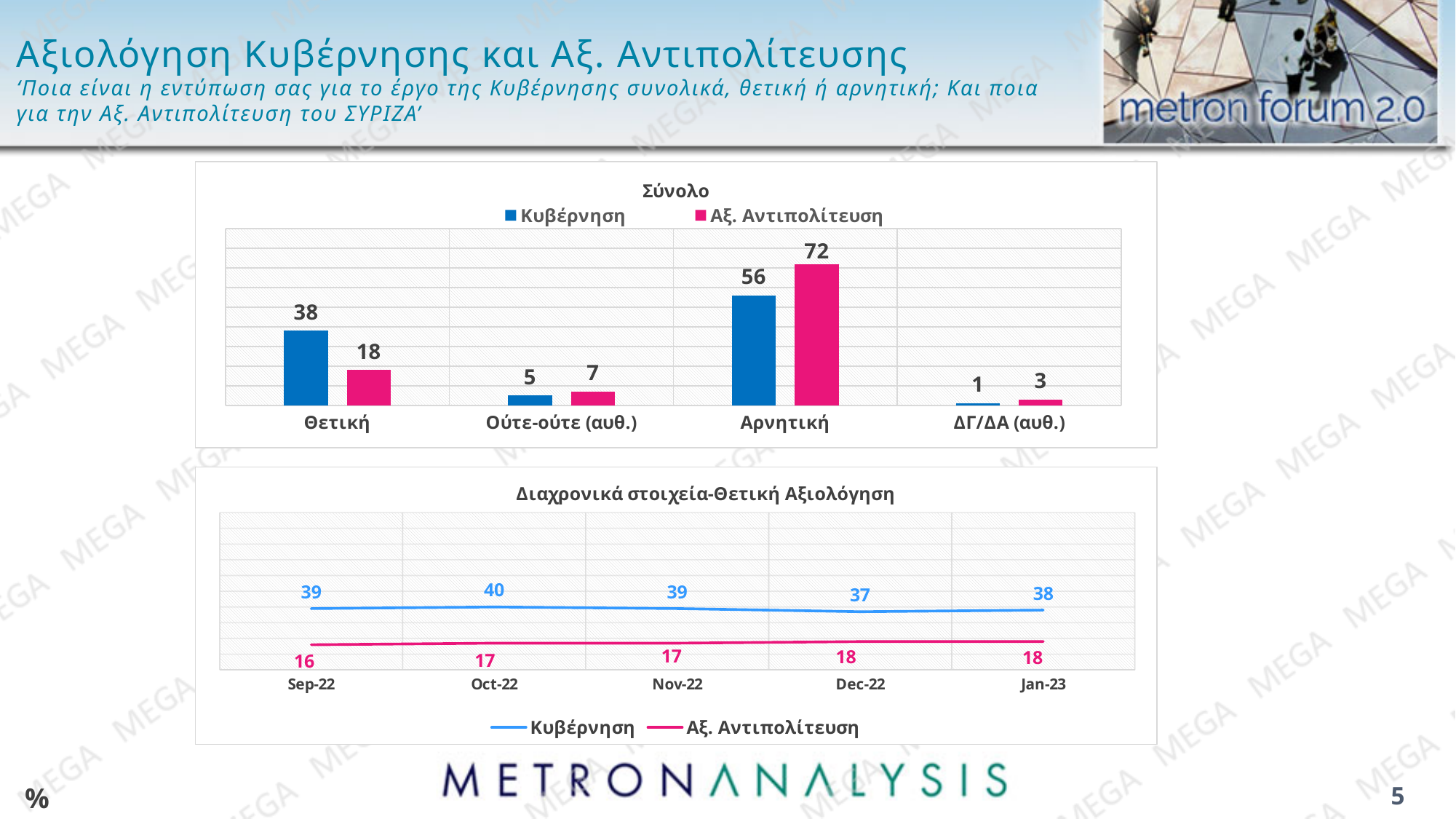
In the 'Διαχρονικά στοιχεία-Θετική Αξιολόγηση' chart, what is the value for Αξ. Αντιπολίτευση in Sep-22? 16 In the 'Σύνολο' chart, what is the value for Κυβέρνηση in the Θετική category? 38 In the 'Διαχρονικά στοιχεία-Θετική Αξιολόγηση' chart, what is the difference between Κυβέρνηση and Αξ. Αντιπολίτευση in Jan-23? 20 In the 'Σύνολο' chart, which category has the highest value for Κυβέρνηση? Αρνητική In the 'Σύνολο' chart, what is the value for Αξ. Αντιπολίτευση in the Αρνητική category? 72 In the 'Σύνολο' chart, which is larger in the Θετική category: Κυβέρνηση or Αξ. Αντιπολίτευση? Κυβέρνηση In the 'Διαχρονικά στοιχεία-Θετική Αξιολόγηση' chart, how many series does the legend list? 2 In the 'Διαχρονικά στοιχεία-Θετική Αξιολόγηση' chart, what is the value for Κυβέρνηση in Oct-22? 40 What type of chart is the 'Σύνολο' chart? Bar chart How many categories are shown on the x axis of the 'Σύνολο' chart? 4 In the 'Σύνολο' chart, what is the difference between Αξ. Αντιπολίτευση and Κυβέρνηση in the Αρνητική category? 16 In the 'Σύνολο' chart, which category has the lowest value for Αξ. Αντιπολίτευση? ΔΓ/ΔΑ (αυθ.)